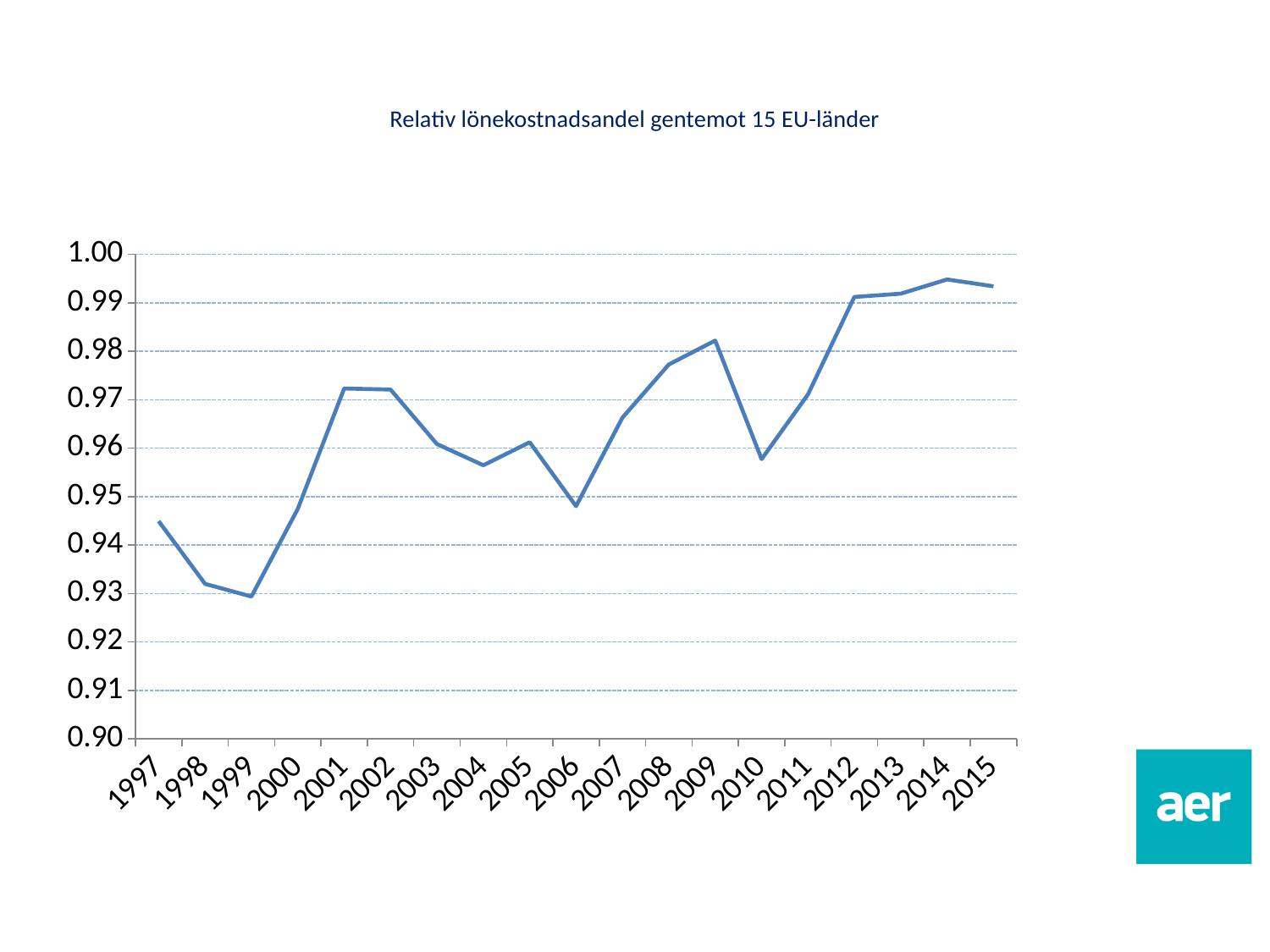
Is the value for 2004 greater or less than 0.96? less Which year has the lowest value? 1999 How many years are plotted along the x axis? 19 Overall, does the value rise or fall from 1997 to 2015? rise Is the value for 2008 greater or less than 0.97? greater What kind of chart is shown on the slide? line chart Is the value for 2013 greater or less than 0.98? greater What is the title of the chart? Relativ lönekostnadsandel gentemot 15 EU-länder Which is larger, the value for 2009 or the value for 2010? 2009 Which is larger, the value for 2001 or the value for 2006? 2001